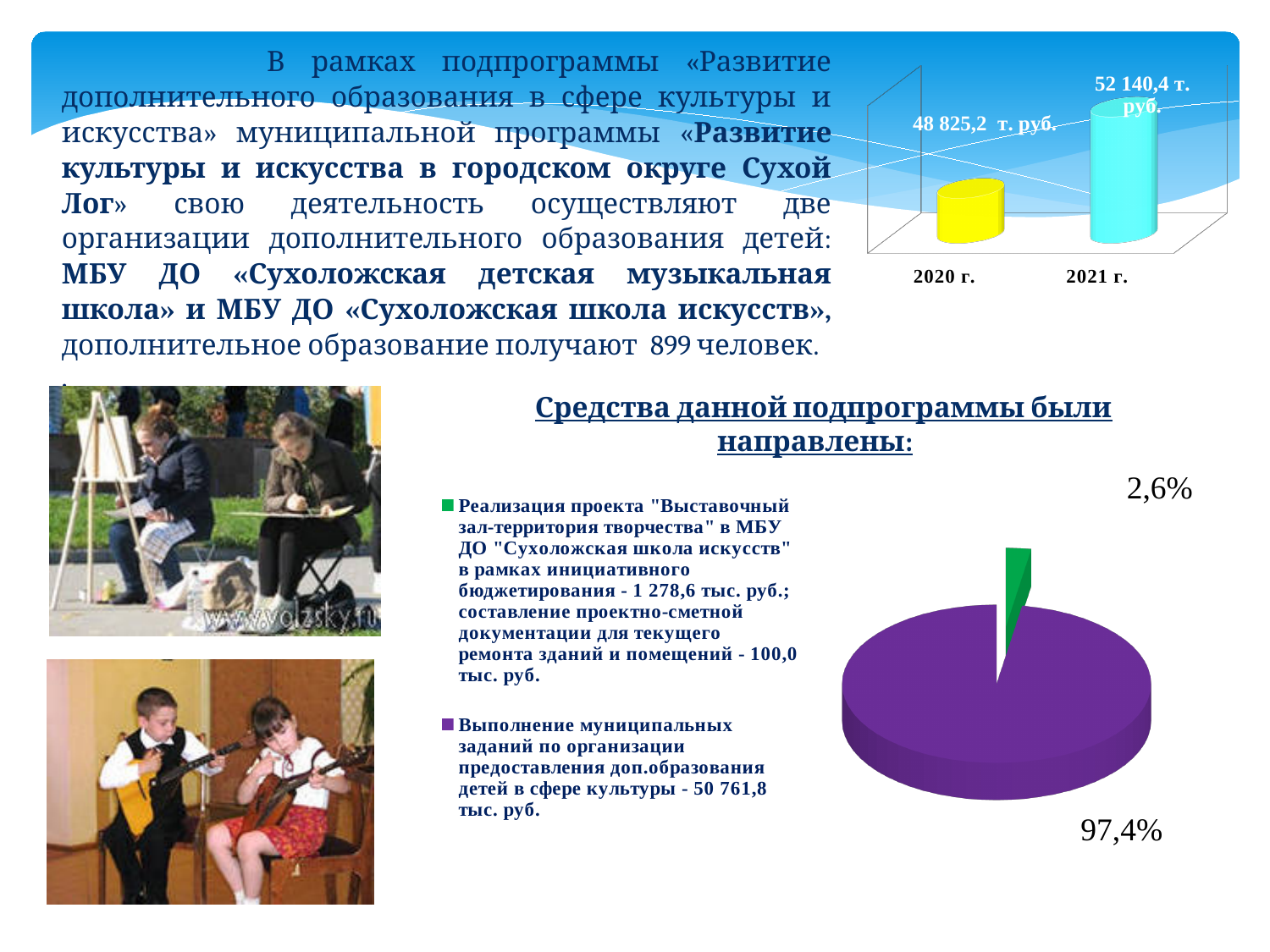
In the bar chart at the top right, what is the value for 2021 г.? 52 140,4 т. руб. In the bar chart at the top right, do the values rise or fall from 2020 г. to 2021 г.? Rise In the bar chart at the top right, which year has the higher value? 2021 г. What kind of chart is shown at the top right of the slide? Bar chart In the pie chart, what share is labelled on the purple slice? 97,4% In the bar chart at the top right, what is the value for 2020 г.? 48 825,2 т. руб. In the bar chart at the top right, which year has the lower value? 2020 г. In the pie chart, what share is labelled on the green slice? 2,6% In the bar chart at the top right, how many categories are shown? 2 How many entries does the legend of the pie chart list? 2 What kind of chart is shown under the heading «Средства данной подпрограммы были направлены:»? Pie chart In the bar chart at the top right, by how much does the 2021 г. value exceed the 2020 г. value? 3 315,2 т. руб.